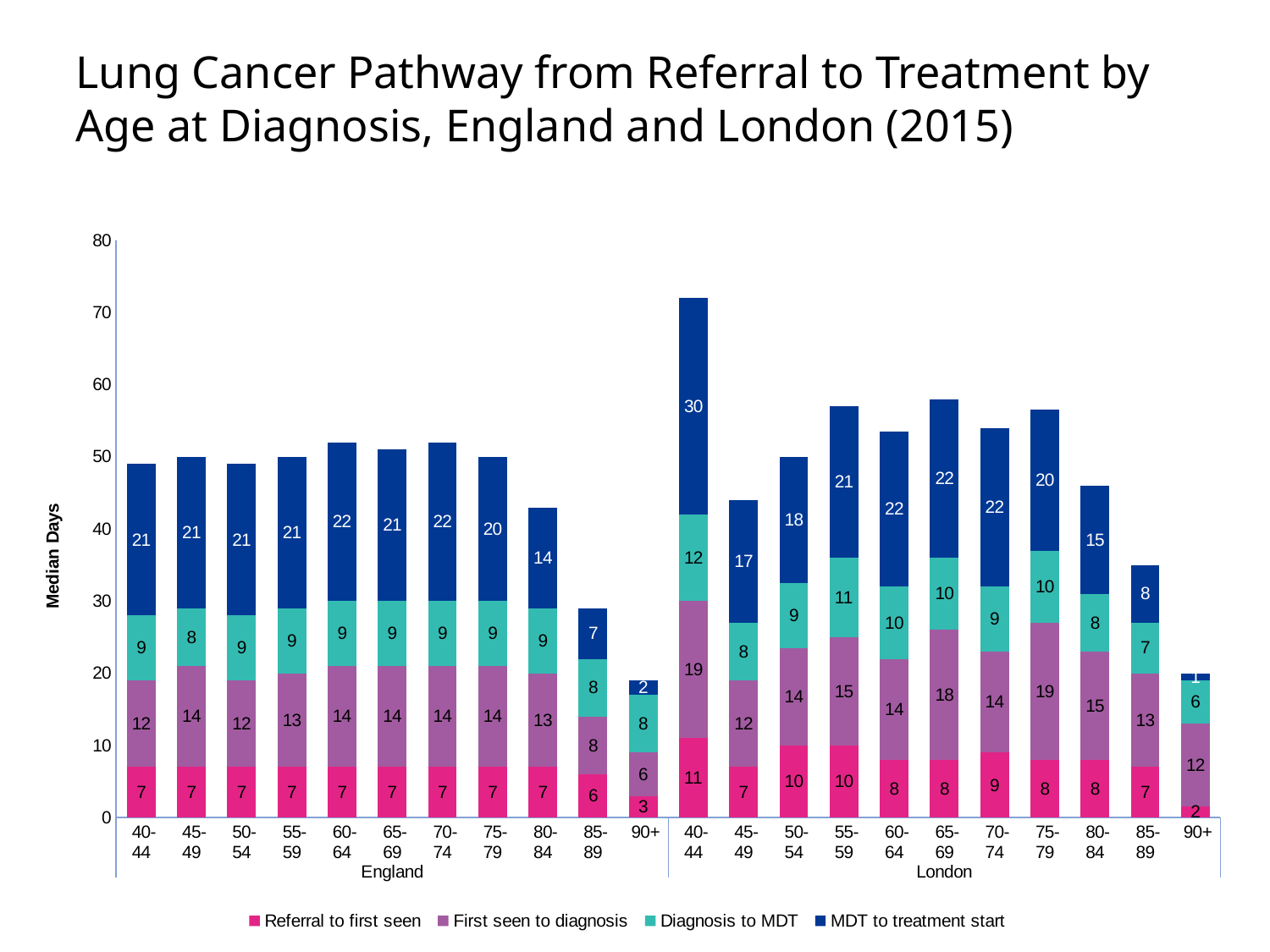
Which age group in England has the shortest stacked bar? 90+ Which is larger: the median days from first seen to diagnosis for the 75-79 age group in London or in England? London What is the total median days for the 40-44 age group in London? 72 What is the total median days for the 90+ age group in England? 19 How many series does the legend list? 4 What is the median number of days from first seen to diagnosis for the 65-69 age group in London? 18 What is the difference in median days from MDT to treatment start between the 40-44 age group in London and the 40-44 age group in England? 9 Which age group in London has the tallest stacked bar? 40-44 What is the median number of days from referral to first seen for the 85-89 age group in England? 6 What kind of chart is shown on the slide? Stacked bar chart What is the median number of days from diagnosis to MDT for the 55-59 age group in London? 11 What is the median number of days from MDT to treatment start for the 40-44 age group in London? 30